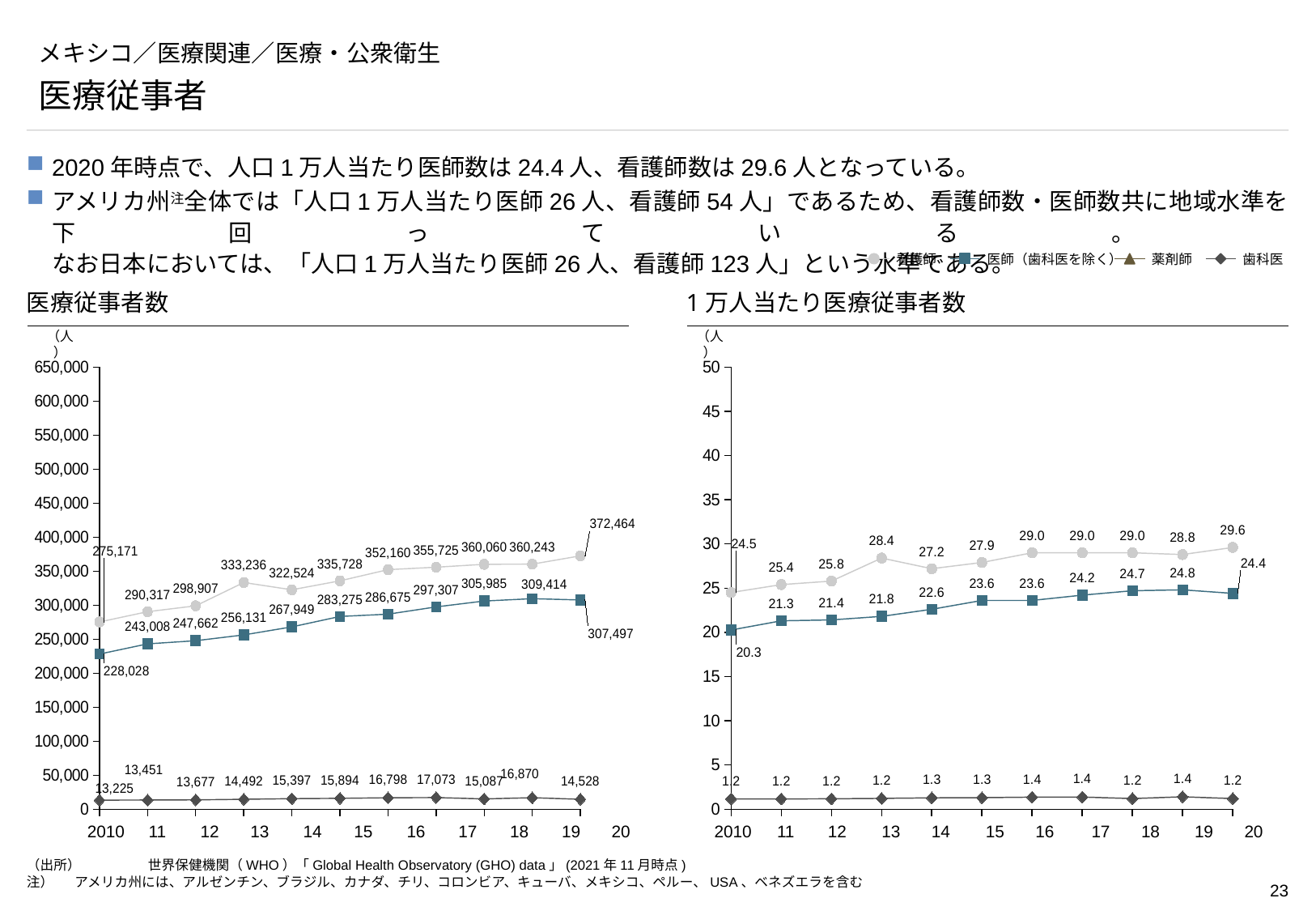
In the 医療従事者数 chart on the left, what is the difference between the 看護師 and 医師（歯科医を除く） values in 2020? 64,967 In the 医療従事者数 chart on the left, is the 看護師 value in 2010 greater or less than 250,000? greater In the 医療従事者数 chart on the left, does the 医師（歯科医を除く） series generally rise or fall from 2010 to 2019? rise What kind of chart is the 医療従事者数 chart on the left? line chart In the 1万人当たり医療従事者数 chart on the right, which is larger in 2014: the 看護師 value or the 医師（歯科医を除く） value? 看護師 In the 1万人当たり医療従事者数 chart on the right, what is the value for 医師（歯科医を除く） in 2020? 24.4 In the 医療従事者数 chart on the left, what is the value for 看護師 in 2020? 372,464 In the 医療従事者数 chart on the left, what is the value for 医師（歯科医を除く） in 2010? 228,028 In the 医療従事者数 chart on the left, in which year is the 歯科医 value highest? 2017 In the 1万人当たり医療従事者数 chart on the right, in which year is the 医師（歯科医を除く） value lowest? 2010 In the 1万人当たり医療従事者数 chart on the right, what is the difference between the 看護師 value in 2020 and in 2010? 5.1 In the 1万人当たり医療従事者数 chart on the right, what is the value for 看護師 in 2013? 28.4